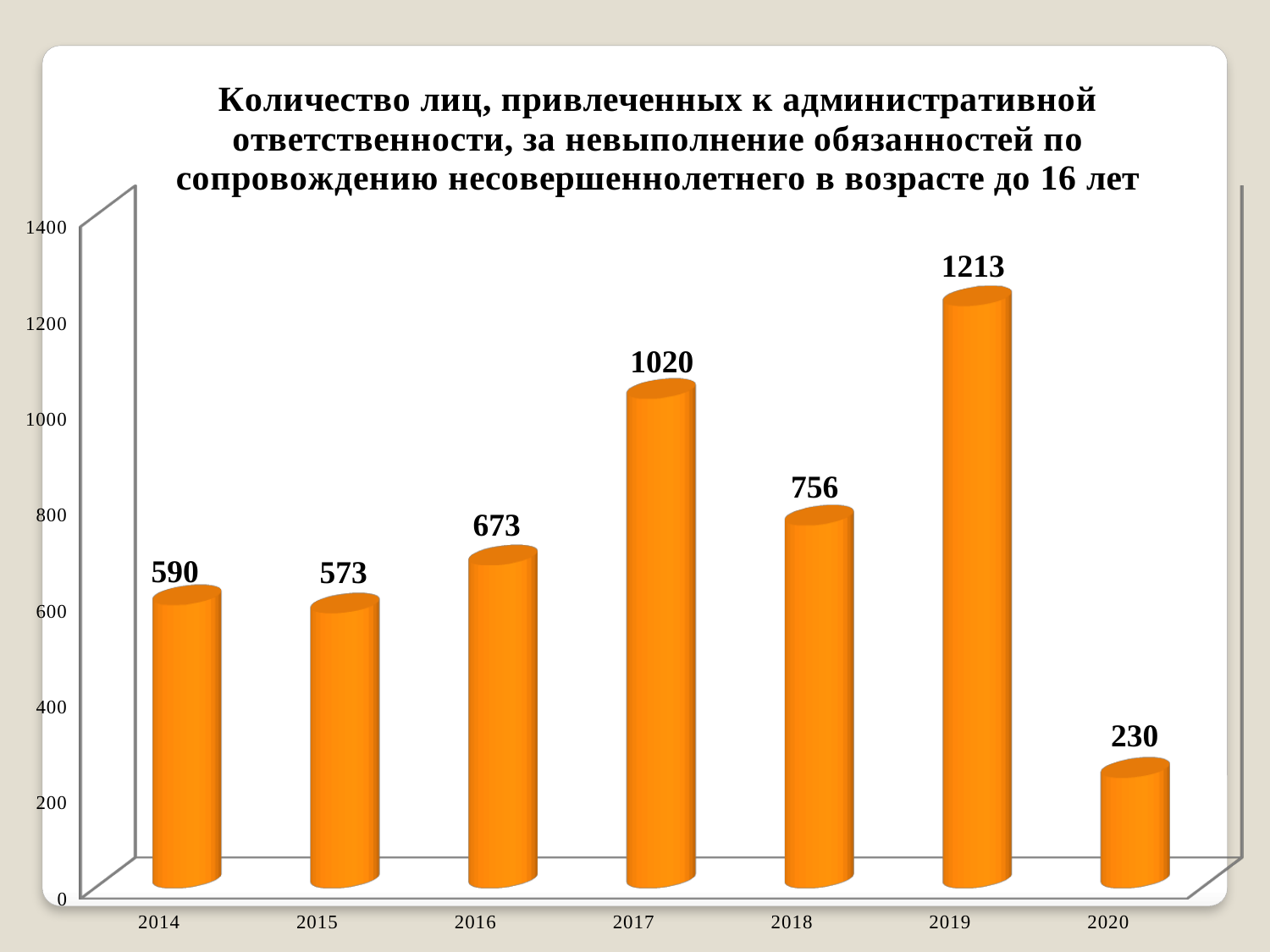
Is the value for 2017 greater or less than 1000? greater What is the value for 2015? 573 What is the value for 2020? 230 What kind of chart is this? bar chart Do the values rise or fall from 2019 to 2020? fall What is the difference between the values for 2014 and 2015? 17 What is the difference between the values for 2019 and 2018? 457 Which year has the lowest value? 2020 Which is larger, the value for 2016 or the value for 2018? 2018 How many years are shown on the x axis? 7 What is the value for 2017? 1020 Which year has the highest value? 2019